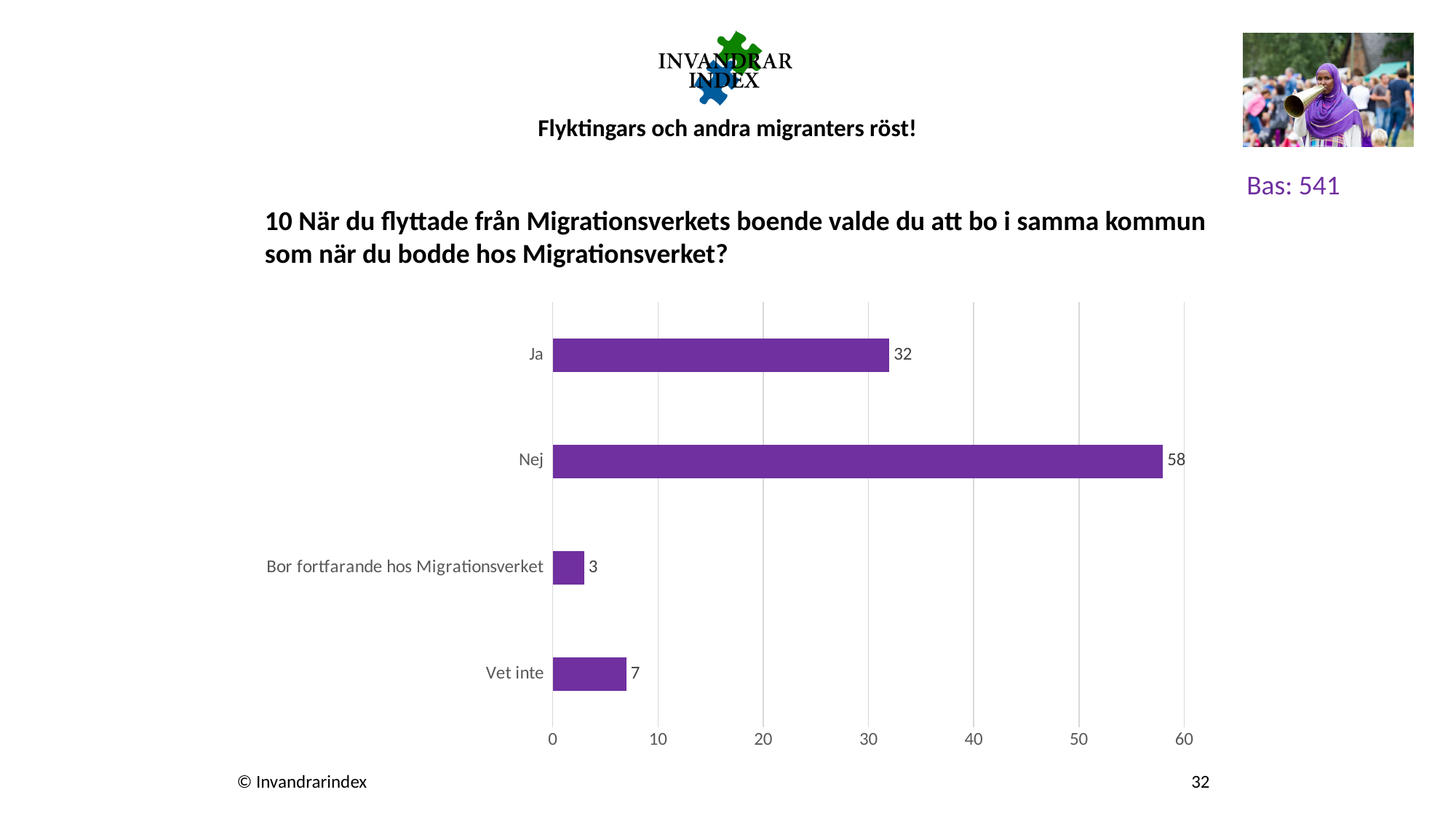
What is the value for "Bor fortfarande hos Migrationsverket"? 3 What is the value for "Ja"? 32 What kind of chart is shown on the slide? bar chart What is the highest value shown on the horizontal axis? 60 Is the value for "Nej" greater or less than 50? greater What is the value for "Nej"? 58 How many categories are shown in the chart? 4 Which category has the highest value? Nej Which category has the lowest value? Bor fortfarande hos Migrationsverket What is the value for "Vet inte"? 7 What is the difference between the values for "Nej" and "Ja"? 26 Which is larger, the value for "Vet inte" or the value for "Bor fortfarande hos Migrationsverket"? Vet inte